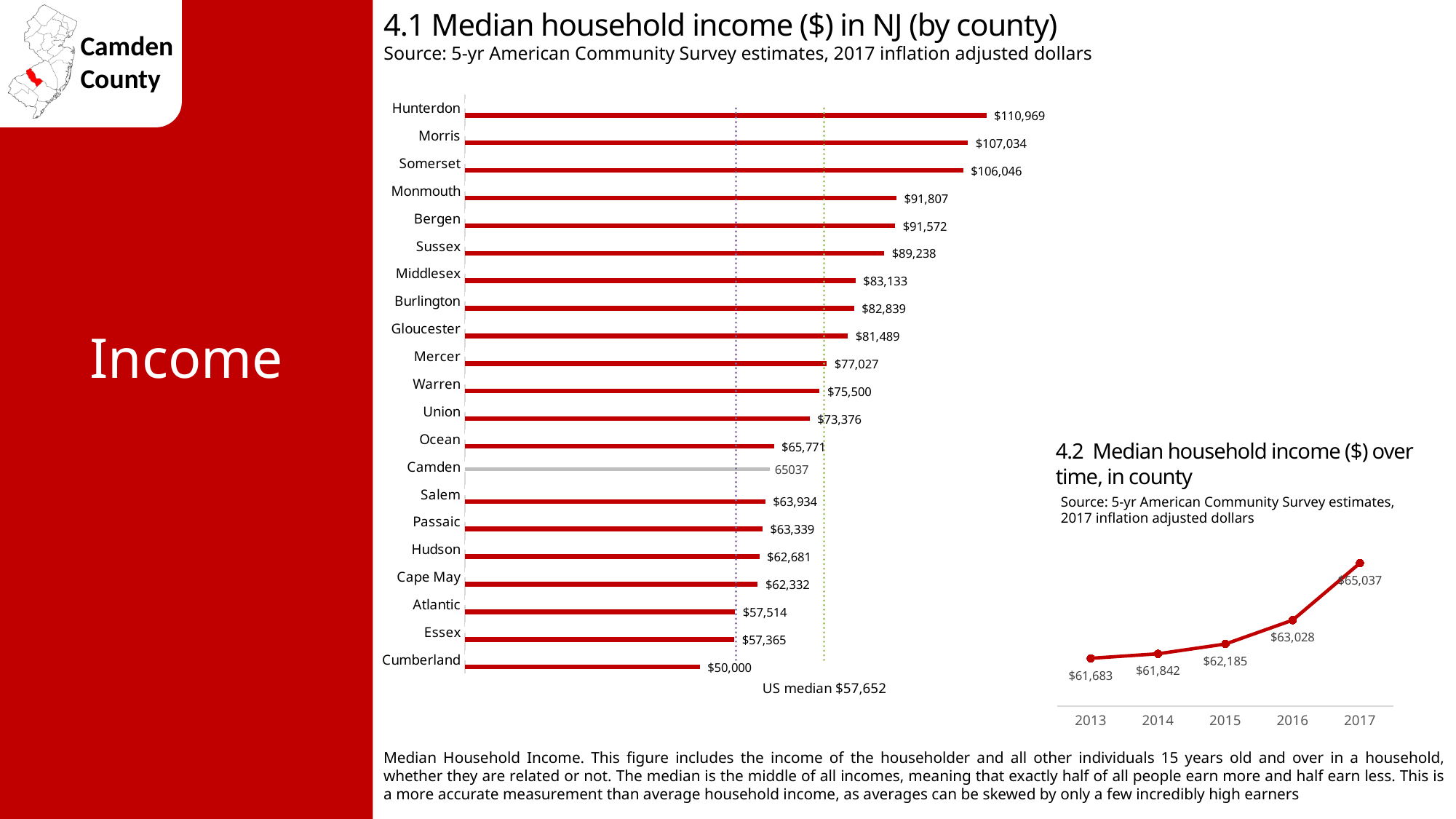
In chart 4.2 Median household income ($) over time, in county, what is the difference between the 2017 and 2013 values? $3,354 In chart 4.1 Median household income ($) in NJ (by county), which county has a higher median household income, Ocean or Salem? Ocean What kind of chart is chart 4.1 Median household income ($) in NJ (by county)? Bar chart In chart 4.2 Median household income ($) over time, in county, what is the value for 2015? $62,185 In chart 4.1 Median household income ($) in NJ (by county), what is the difference between the values for Hunterdon and Cumberland? $60,969 In chart 4.2 Median household income ($) over time, in county, do the values rise or fall from 2013 to 2017? Rise In chart 4.2 Median household income ($) over time, in county, how many years are plotted? 5 In chart 4.1 Median household income ($) in NJ (by county), which county has the lowest median household income? Cumberland In chart 4.1 Median household income ($) in NJ (by county), how many counties are plotted? 21 In chart 4.1 Median household income ($) in NJ (by county), which county has the highest median household income? Hunterdon In chart 4.1 Median household income ($) in NJ (by county), what is the median household income for Gloucester? $81,489 In chart 4.1 Median household income ($) in NJ (by county), what value is labelled for Camden? 65037